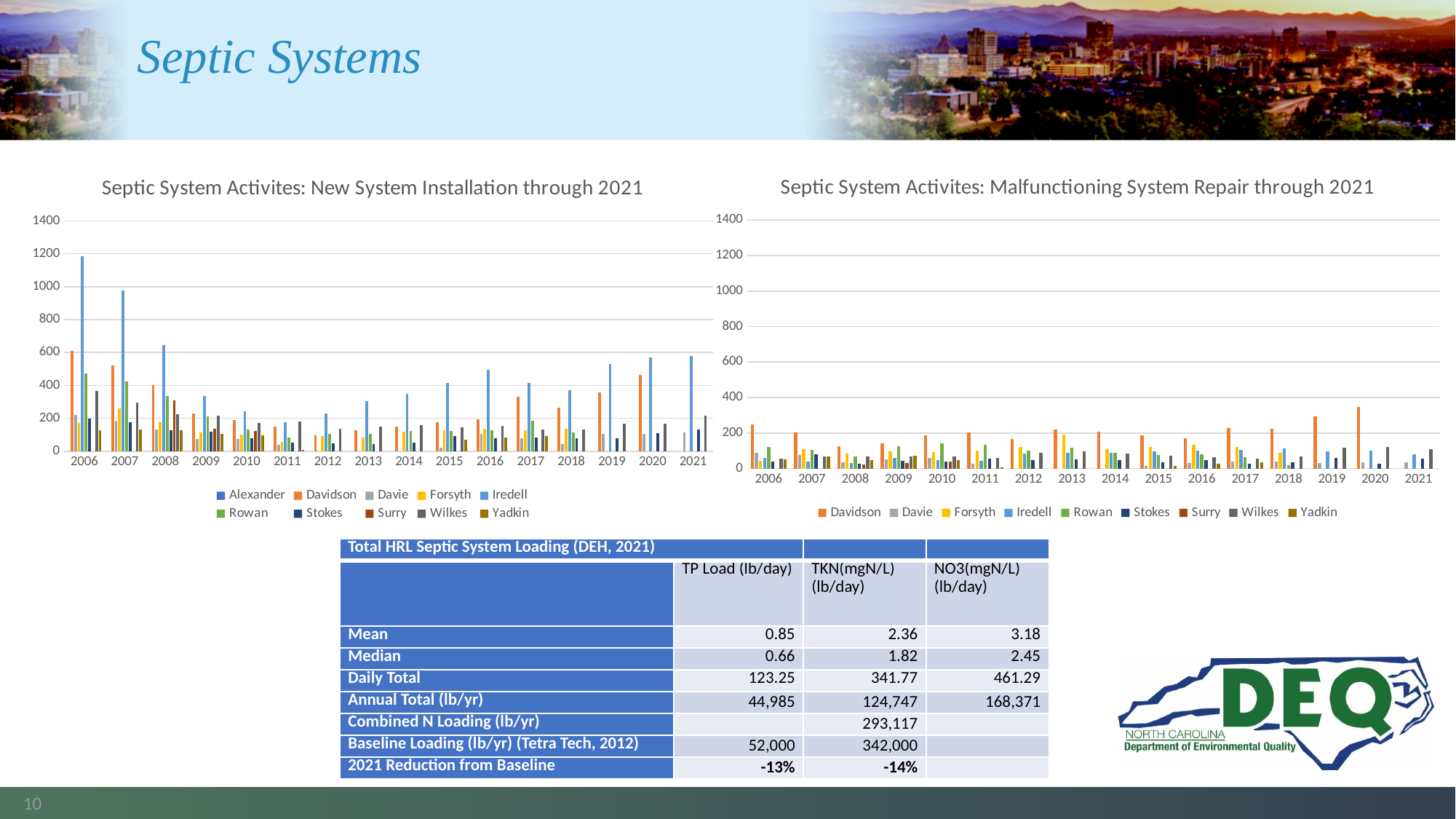
In the 'Malfunctioning System Repair through 2021' chart, which county has the tallest bar in 2006? Davidson In the 'New System Installation through 2021' chart, is the value for Iredell in 2006 greater or less than 1000? greater In the 'New System Installation through 2021' chart, which county has the tallest bar in 2006? Iredell Which county appears in the legend of the 'New System Installation through 2021' chart but not in the legend of the 'Malfunctioning System Repair through 2021' chart? Alexander In the 'Malfunctioning System Repair through 2021' chart, is the value for Davidson in 2006 greater or less than 400? less What kind of chart is the 'Septic System Activites: New System Installation through 2021' chart? bar chart In the 'New System Installation through 2021' chart, which year has the tallest bar overall? 2006 In the 'Malfunctioning System Repair through 2021' chart, is the value for Davidson in 2020 greater or less than 200? greater How many series does the legend of the 'New System Installation through 2021' chart list? 10 How many series does the legend of the 'Malfunctioning System Repair through 2021' chart list? 9 How many years are shown on the x axis of the 'New System Installation through 2021' chart? 16